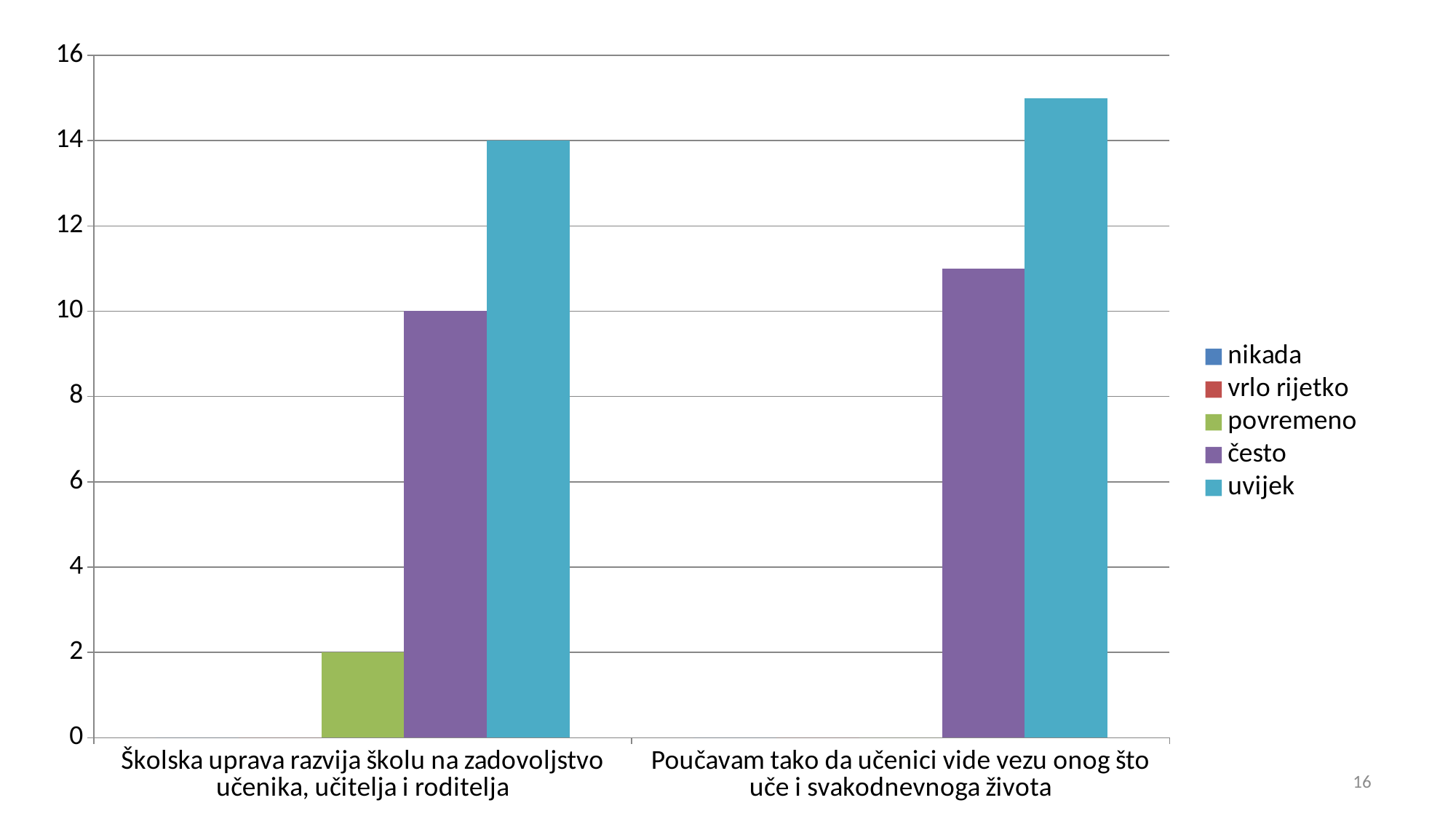
How many series does the legend list? 5 Which is larger for "uvijek": the value in "Školska uprava razvija školu na zadovoljstvo učenika, učitelja i roditelja" or in "Poučavam tako da učenici vide vezu onog što uče i svakodnevnoga života"? Poučavam tako da učenici vide vezu onog što uče i svakodnevnoga života What is the difference between "uvijek" and "često" in the category "Školska uprava razvija školu na zadovoljstvo učenika, učitelja i roditelja"? 4 Which series has the lowest non-zero value in the category "Školska uprava razvija školu na zadovoljstvo učenika, učitelja i roditelja"? povremeno Is the value for "često" in the category "Poučavam tako da učenici vide vezu onog što uče i svakodnevnoga života" greater or less than 10? greater How many categories are shown on the x axis? 2 Which series has the highest value in the category "Poučavam tako da učenici vide vezu onog što uče i svakodnevnoga života"? uvijek What is the value for "povremeno" in the category "Školska uprava razvija školu na zadovoljstvo učenika, učitelja i roditelja"? 2 What kind of chart is shown on the slide? bar chart What is the value for "uvijek" in the category "Školska uprava razvija školu na zadovoljstvo učenika, učitelja i roditelja"? 14 Is the value for "uvijek" in the category "Poučavam tako da učenici vide vezu onog što uče i svakodnevnoga života" greater or less than 14? greater What is the value for "često" in the category "Školska uprava razvija školu na zadovoljstvo učenika, učitelja i roditelja"? 10